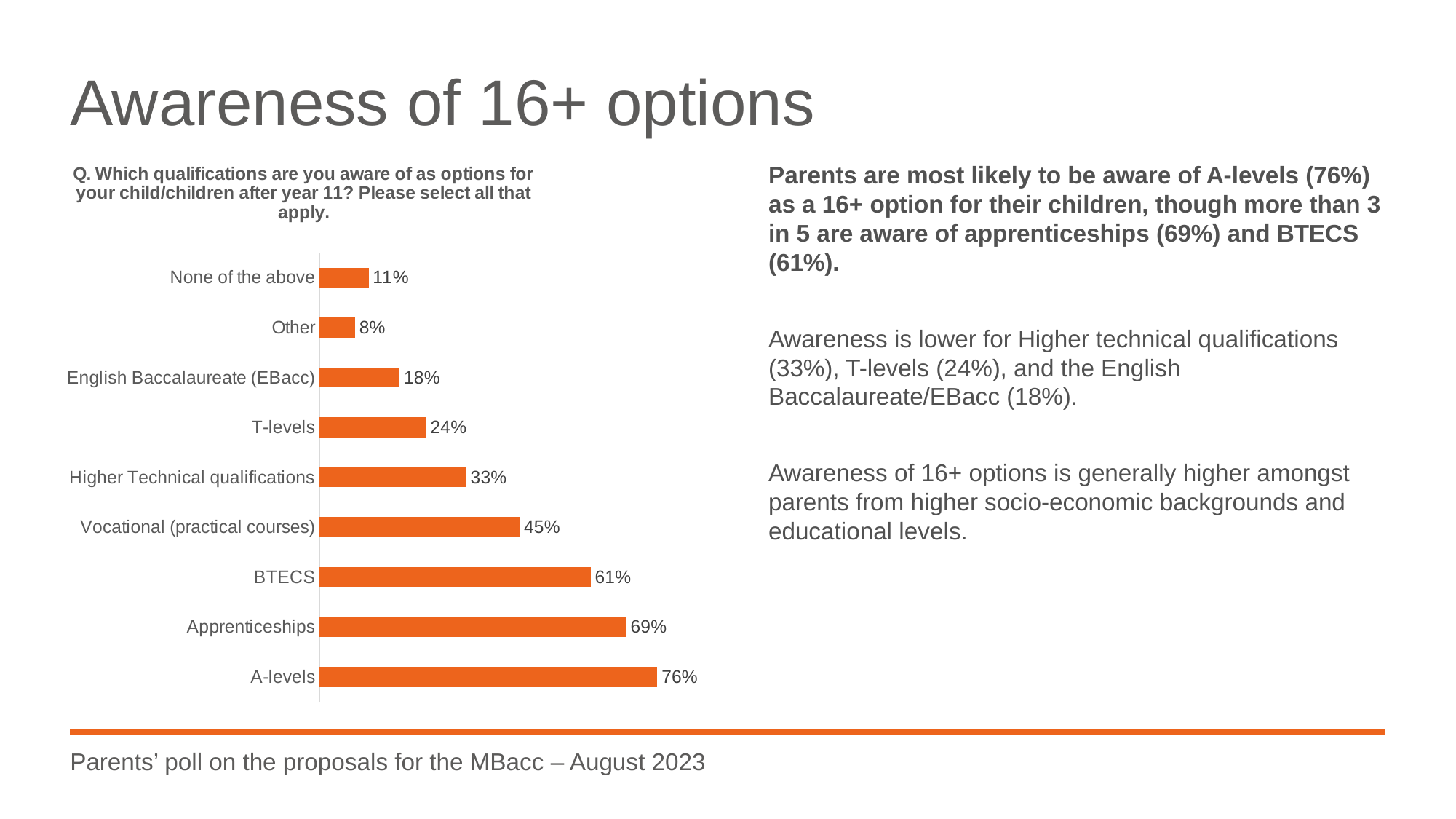
What percentage of parents are aware of A-levels as a 16+ option? 76% What colour are the bars in the chart? Orange How many categories are shown in the chart? 9 What type of chart is shown on the slide? Bar chart What is the difference between the values for Apprenticeships and BTECS? 8% Which category has the highest value in the chart? A-levels Which has a larger value, BTECS or Vocational (practical courses)? BTECS What is the value shown for T-levels? 24% Which category has the lowest value in the chart? Other What is the difference between the values for Higher Technical qualifications and English Baccalaureate (EBacc)? 15% Which has a larger value, None of the above or Other? None of the above What percentage is shown for Vocational (practical courses)? 45%